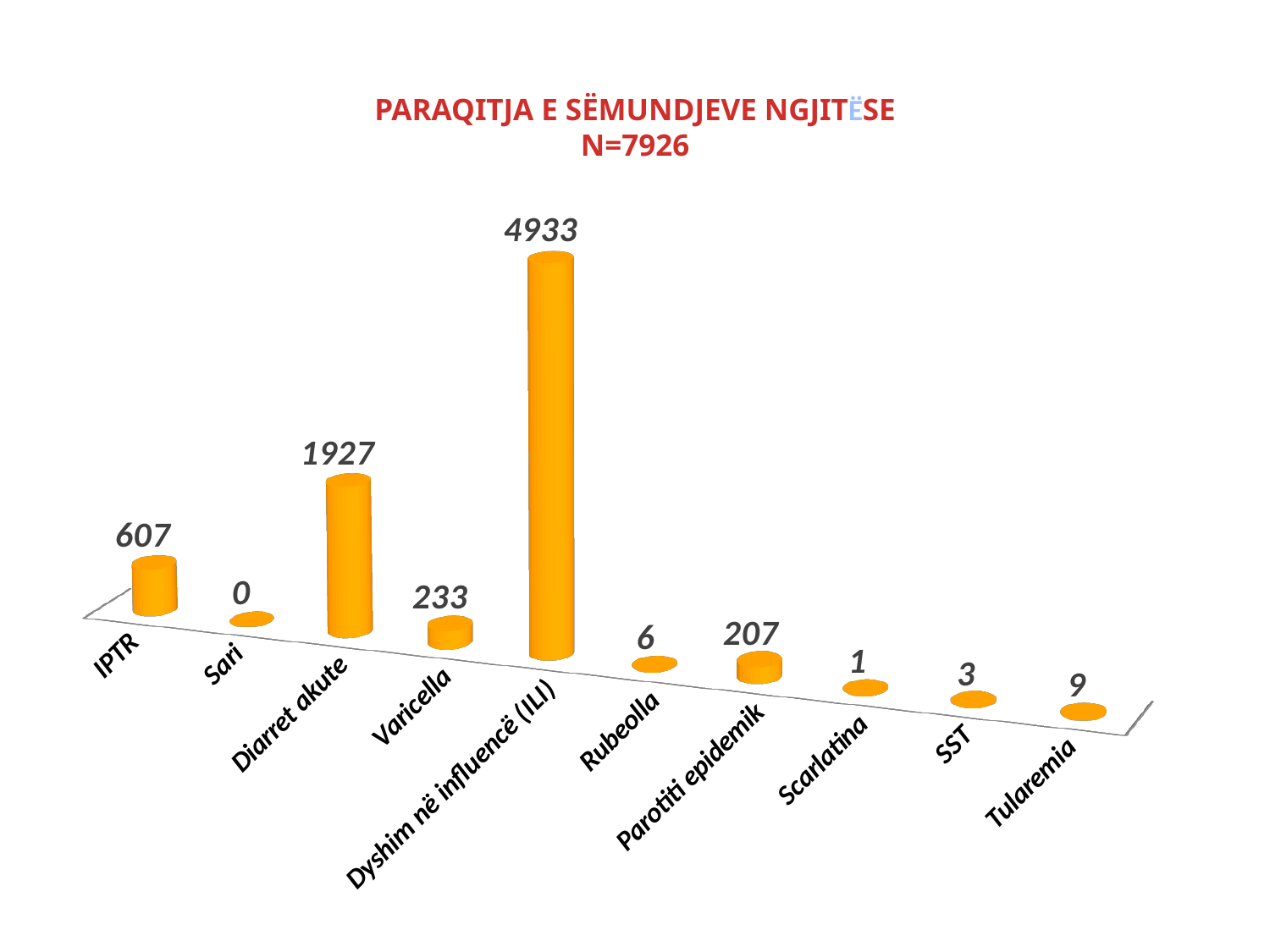
What is the value for Dyshim në influencë (ILI)? 4933 What is the difference between the values for Dyshim në influencë (ILI) and Diarret akute? 3006 Which is larger, the value for Varicella or the value for Parotiti epidemik? Varicella What is the value for Parotiti epidemik? 207 What kind of chart is shown on the slide? bar chart Which category has the highest value? Dyshim në influencë (ILI) What is the value for IPTR? 607 What is the N value stated in the chart title? N=7926 What is the difference between the values for IPTR and Varicella? 374 What is the value for Diarret akute? 1927 How many categories are shown on the chart? 10 Which category has the lowest value? Sari